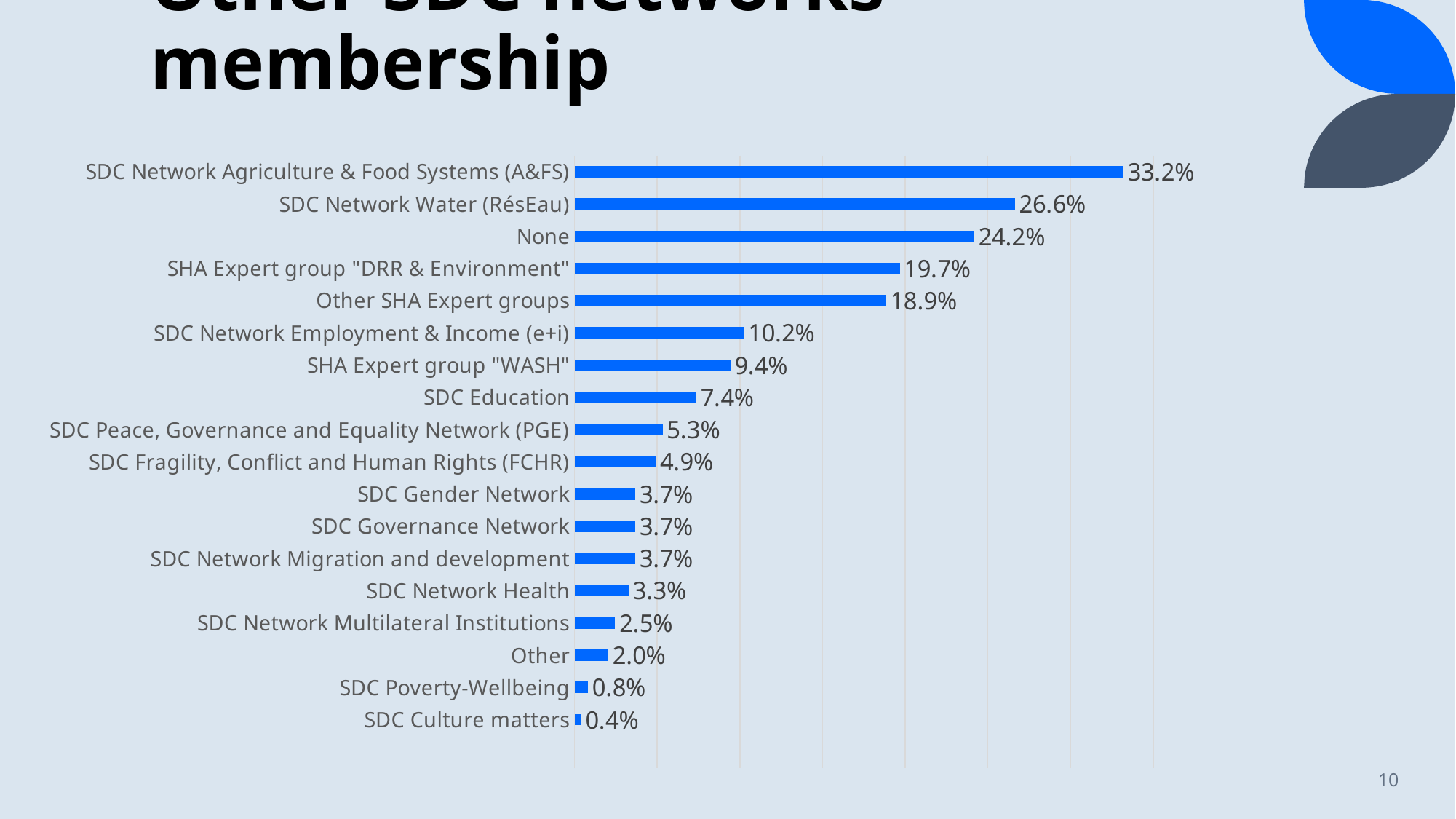
What is the value for SDC Network Water (RésEau)? 26.6% What is the difference between the values for SDC Network Agriculture & Food Systems (A&FS) and SDC Network Water (RésEau)? 6.6% Which is larger, the value for SDC Education or the value for SDC Network Employment & Income (e+i)? SDC Network Employment & Income (e+i) Which category has the lowest value? SDC Culture matters Which category has the highest value? SDC Network Agriculture & Food Systems (A&FS) What is the difference between the values for SDC Poverty-Wellbeing and SDC Culture matters? 0.4% What kind of chart is shown on the slide? bar chart What is the value for SDC Network Multilateral Institutions? 2.5% How many categories are shown in the chart? 18 What is the value for SHA Expert group "WASH"? 9.4% What is the value for SDC Network Agriculture & Food Systems (A&FS)? 33.2% What is the value for None? 24.2%